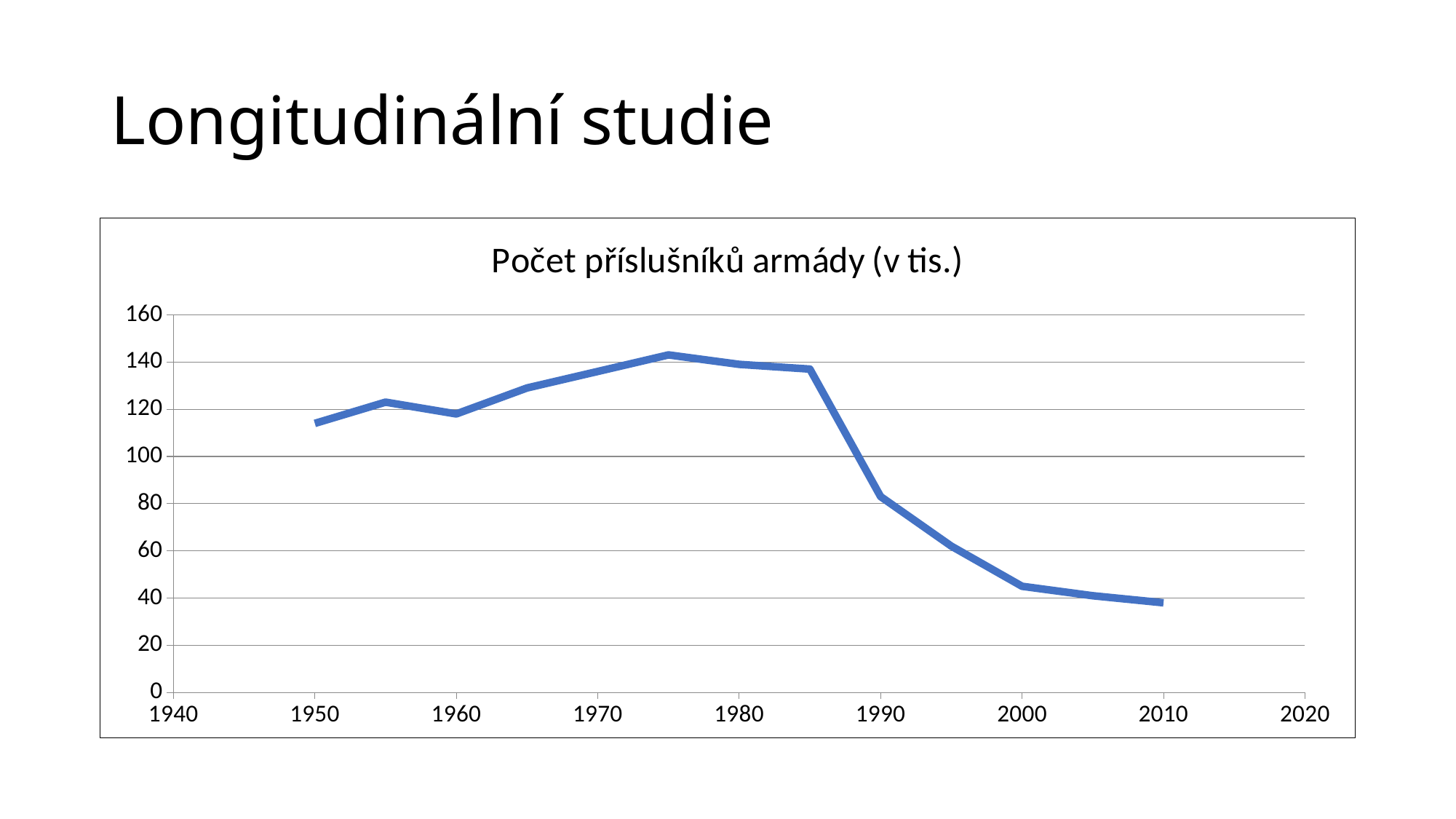
Is the value for 1950 greater or less than 100? greater In which year does the line reach its lowest value? 2010 Is the value for 1990 greater or less than 100? less What kind of chart is shown on the slide? line chart Is the value for 2000 greater or less than 60? less Which year has the larger value, 1960 or 1970? 1970 In which year does the line reach its highest value? 1975 Does the line rise or fall between 1985 and 2010? fall Which year has the larger value, 1950 or 1990? 1950 What is the title of the chart? Počet příslušníků armády (v tis.)